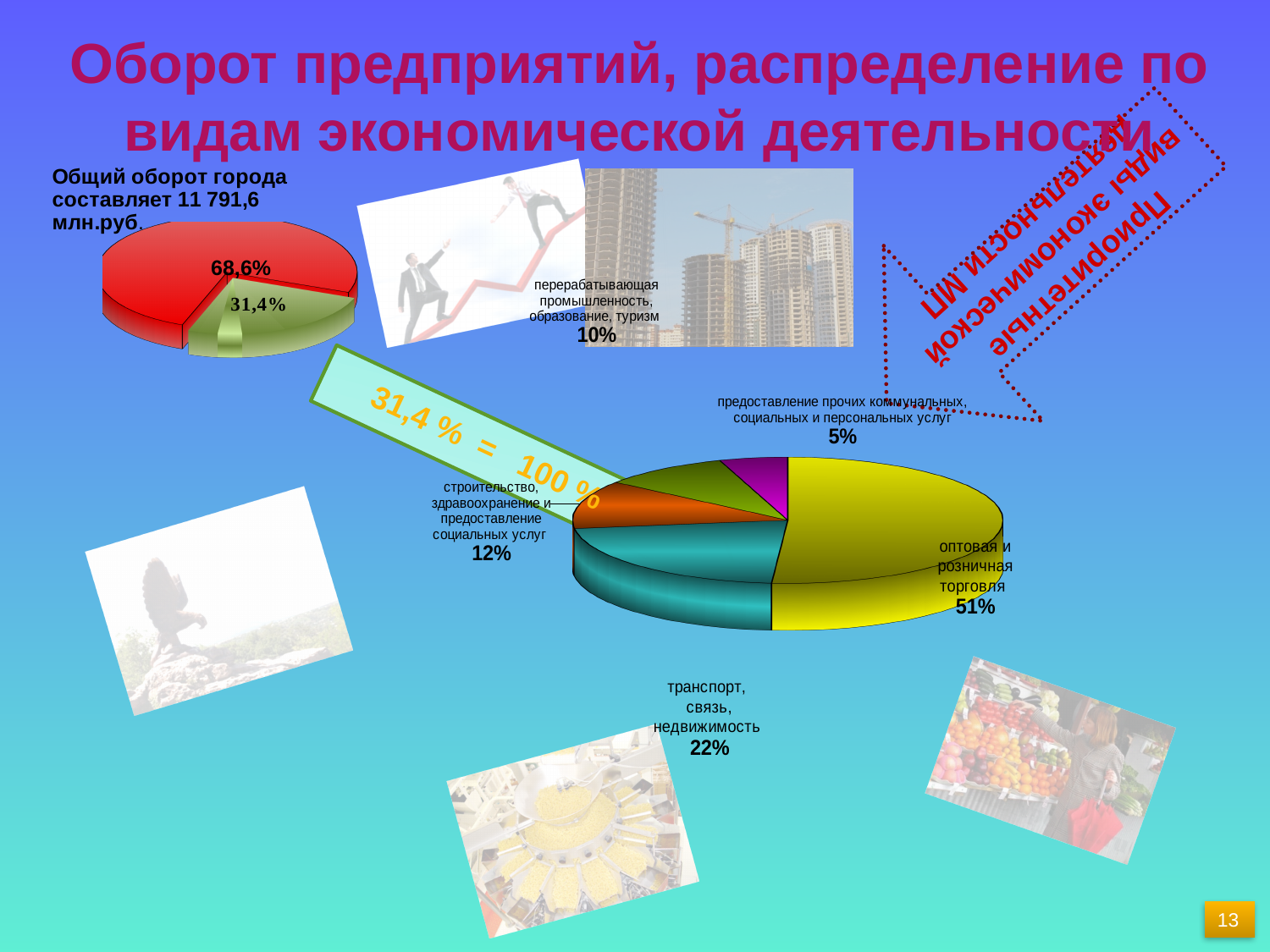
In the large pie chart in the lower right, what share is labelled for оптовая и розничная торговля? 51% In the large pie chart in the lower right, what share is labelled for предоставление прочих коммунальных, социальных и персональных услуг? 5% In the large pie chart in the lower right, what share is labelled for строительство, здравоохранение и предоставление социальных услуг? 12% In the large pie chart in the lower right, what is the difference in percentage points between оптовая и розничная торговля and транспорт, связь, недвижимость? 29 In the small pie chart in the upper left, which slice is larger, the red one or the green one? the red one In the large pie chart in the lower right, what share is labelled for транспорт, связь, недвижимость? 22% In the small pie chart in the upper left, what are the two labelled shares? 68,6% and 31,4% What type of chart is the large chart in the lower right of the slide? pie chart In the large pie chart in the lower right, which category has the largest share? оптовая и розничная торговля In the large pie chart in the lower right, what share is labelled for перерабатывающая промышленность, образование, туризм? 10% In the large pie chart in the lower right, which category has the smallest share? предоставление прочих коммунальных, социальных и персональных услуг In the large pie chart in the lower right, how many slices are there? 5